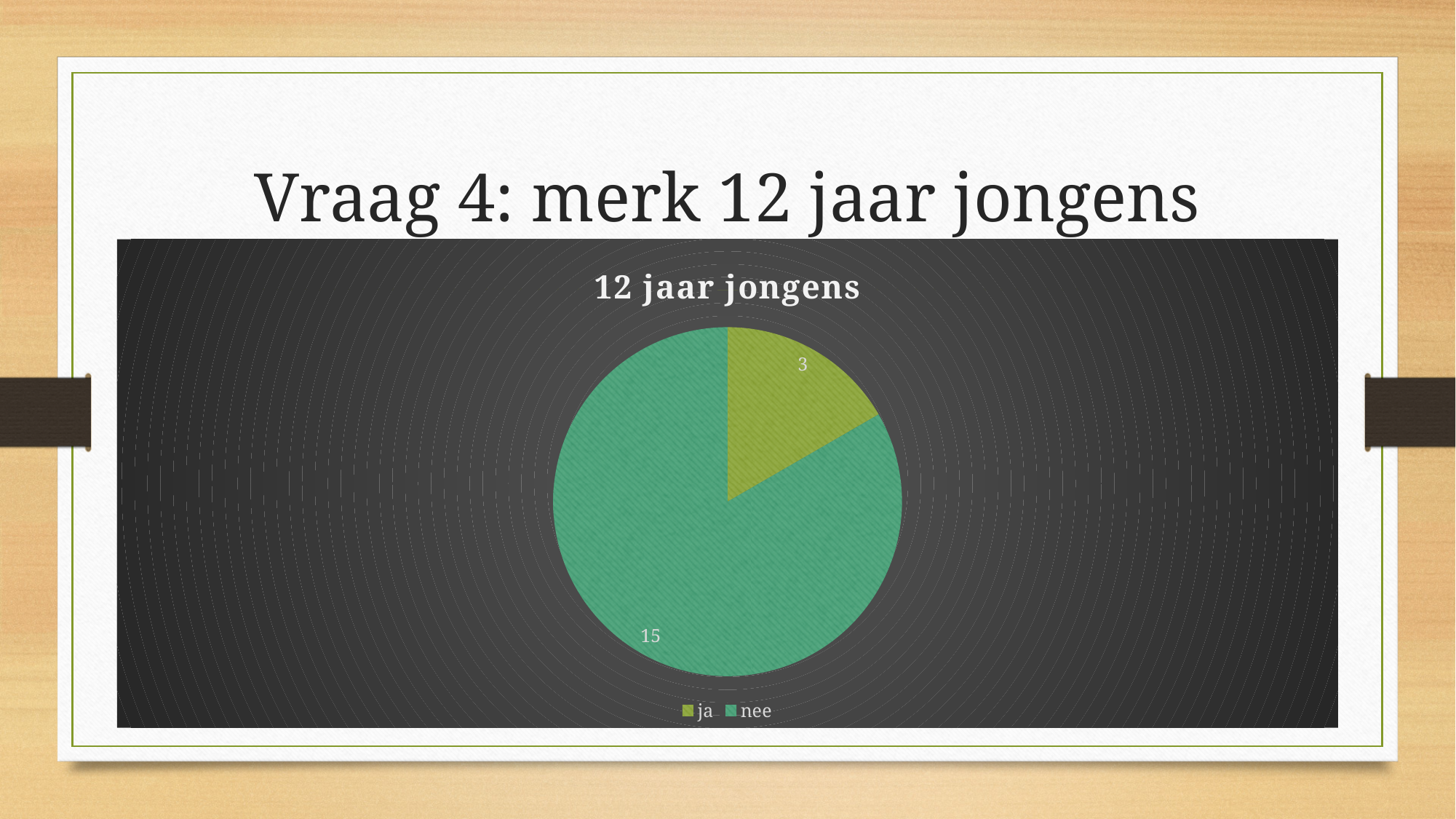
Which category has the largest slice? nee Which category has the smallest slice? ja What type of chart is shown on the slide? pie chart Which is larger, the value for "ja" or the value for "nee"? nee What colour is the "nee" slice? green What is the title of the chart? 12 jaar jongens What is the value for "nee"? 15 What is the value for "ja"? 3 What is the total of all slices in the pie chart? 18 How many entries does the legend list? 2 How many categories does the pie chart have? 2 What is the difference between the values for "nee" and "ja"? 12